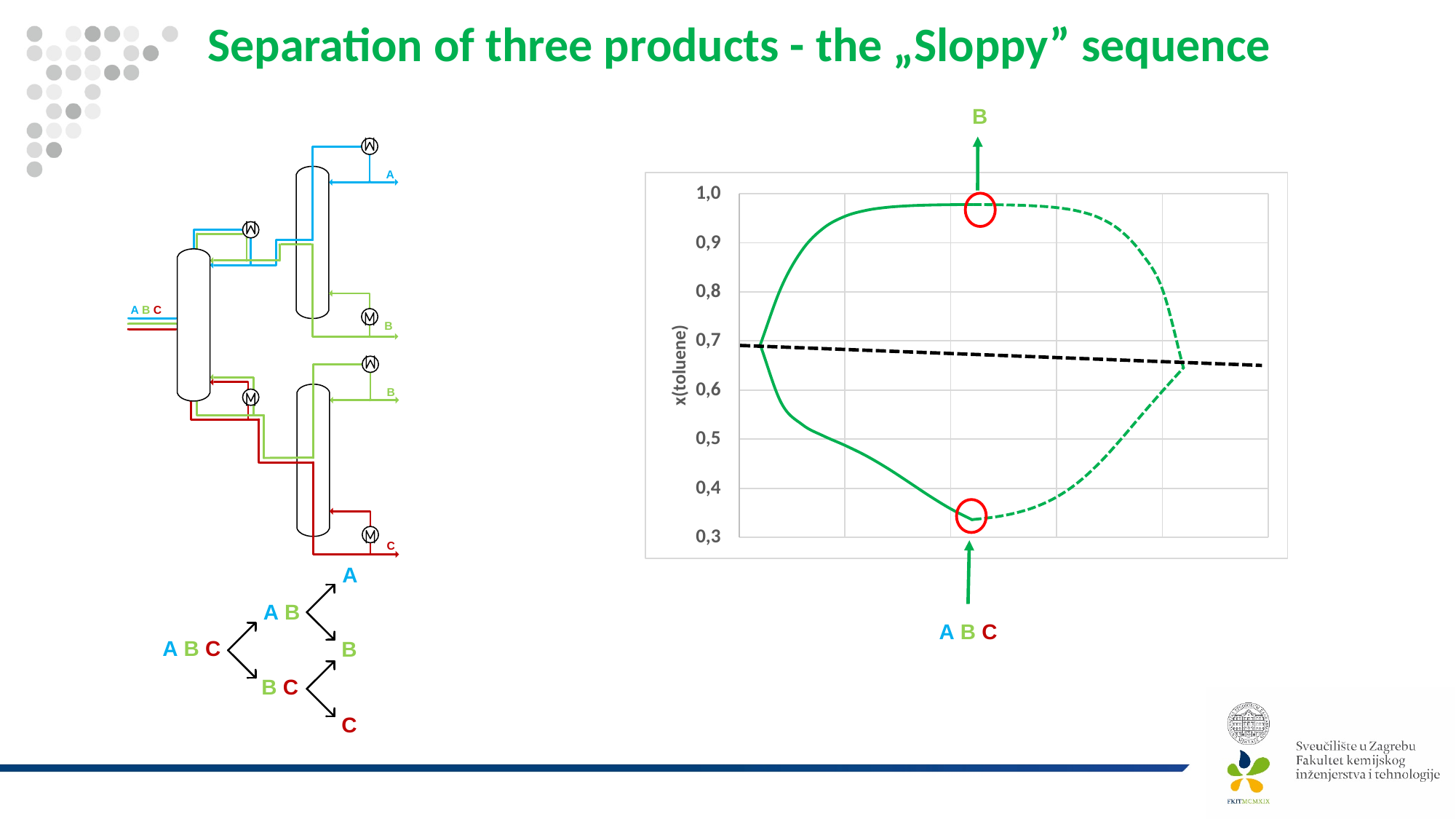
Which circled point has the higher x(toluene) value, the one marked B or the one marked A B C? B What is the label of the vertical axis of the chart? x(toluene) What kind of chart is shown on the right side of the slide? line chart Is the x(toluene) value at the right end of the black dashed line greater or less than 0,7? less Is the x(toluene) value at the circled point marked A B C greater or less than 0,4? less Is the x(toluene) value at the circled point marked B greater or less than 0,9? greater Does the black dashed line rise or fall from left to right across the chart? fall What is the lowest value shown on the vertical axis of the chart? 0,3